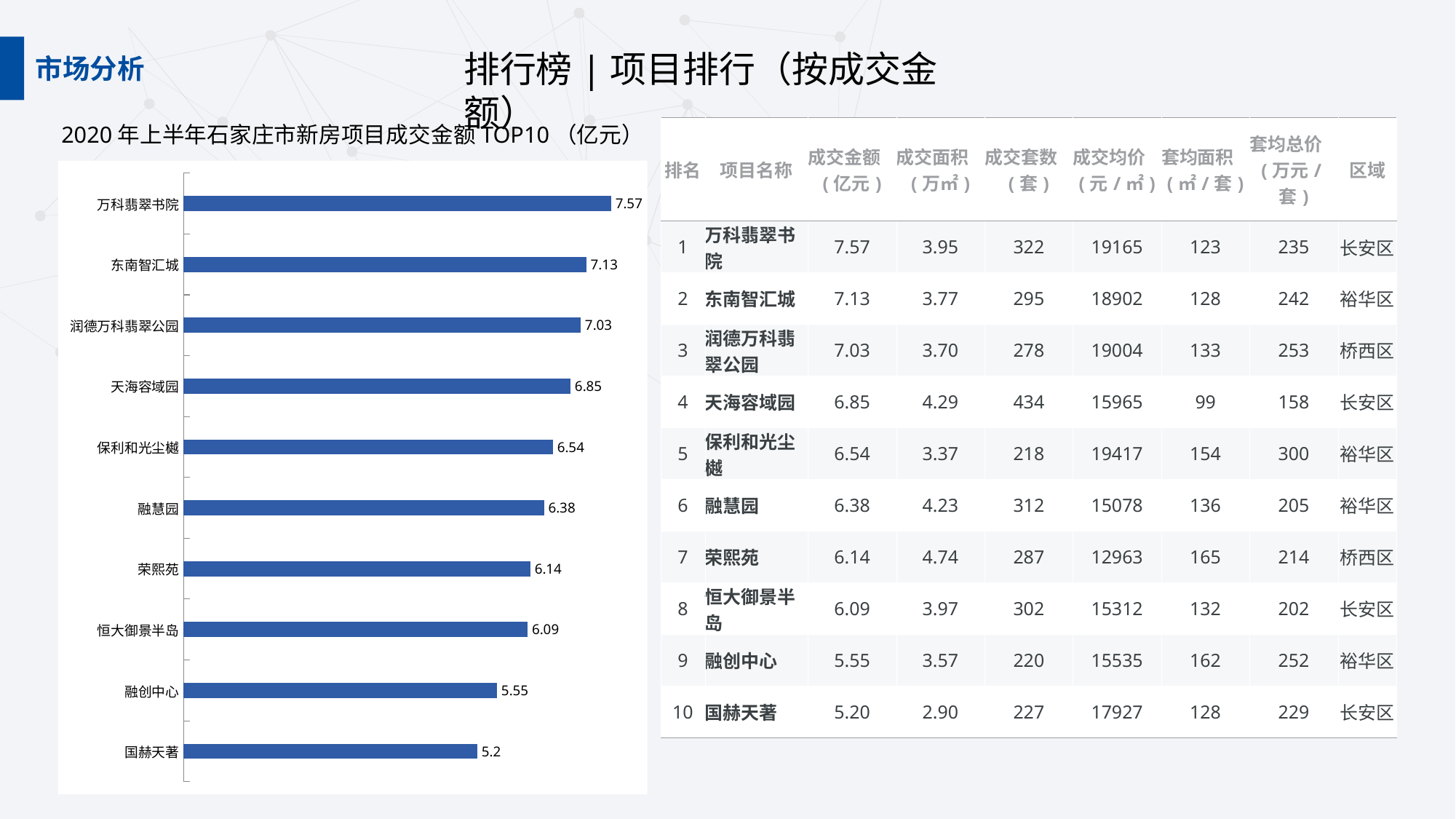
What is the value for 天海容域园 in the bar chart? 6.85 How many projects are shown in the bar chart? 10 Which project has the highest value in the bar chart? 万科翡翠书院 What is the difference between the values for 融创中心 and 国赫天著 in the bar chart? 0.35 What is the value for 荣熙苑 in the bar chart? 6.14 Which is larger in the bar chart, the value for 保利和光尘樾 or the value for 融慧园? 保利和光尘樾 What is the value for 国赫天著 in the bar chart? 5.2 What is the value for 万科翡翠书院 in the bar chart? 7.57 What is the title of the bar chart? 2020 年上半年石家庄市新房项目成交金额 TOP10 （亿元） What is the difference between the values for 万科翡翠书院 and 东南智汇城 in the bar chart? 0.44 What kind of chart is shown on the slide? bar chart Which project has the lowest value in the bar chart? 国赫天著